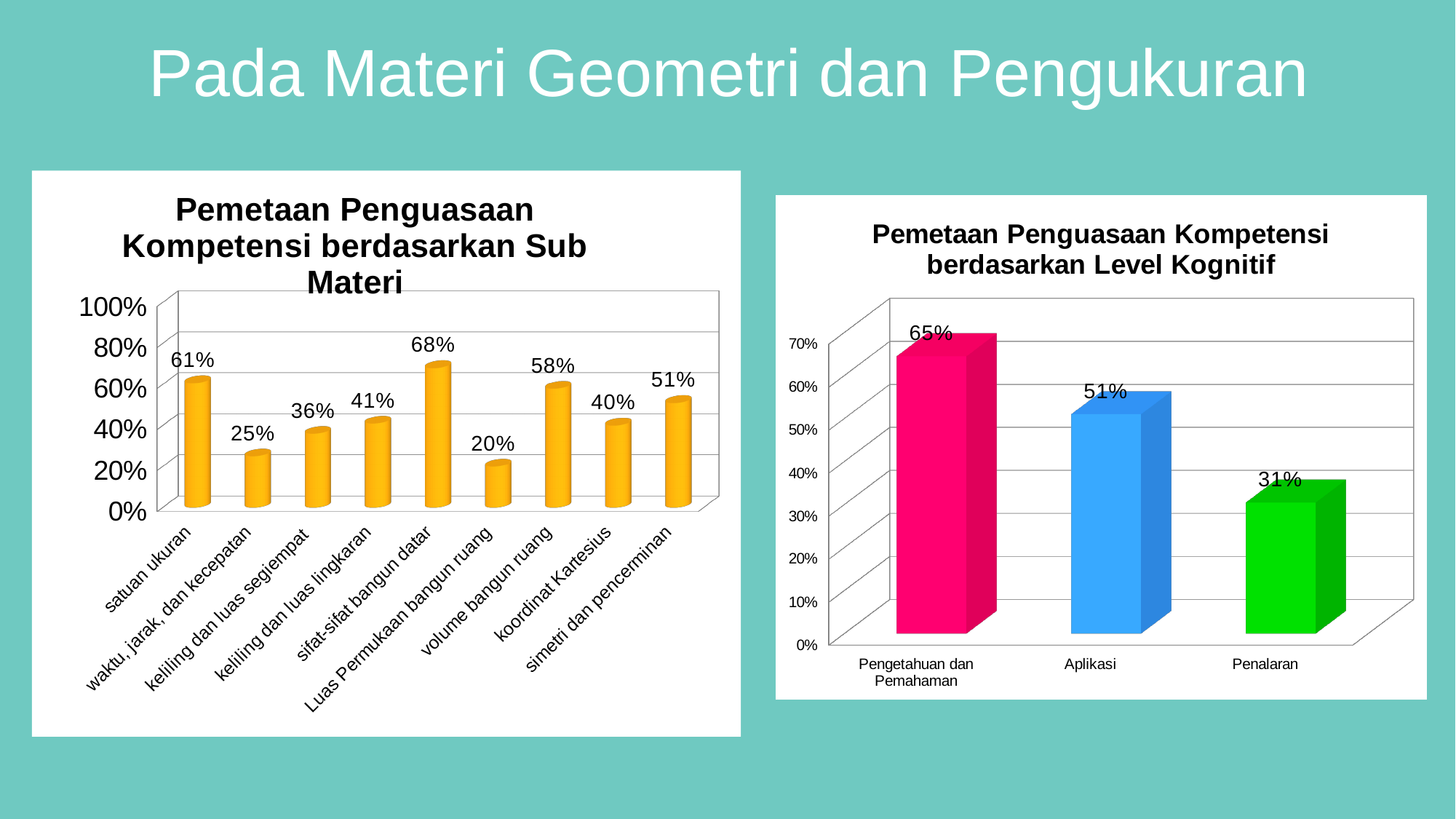
In the left chart (Pemetaan Penguasaan Kompetensi berdasarkan Sub Materi), how many sub materi categories are shown? 9 In the right chart (Pemetaan Penguasaan Kompetensi berdasarkan Level Kognitif), which level has the lowest value? Penalaran In the left chart (Pemetaan Penguasaan Kompetensi berdasarkan Sub Materi), what is the value for koordinat Kartesius? 40% In the right chart (Pemetaan Penguasaan Kompetensi berdasarkan Level Kognitif), what is the value for Aplikasi? 51% In the left chart (Pemetaan Penguasaan Kompetensi berdasarkan Sub Materi), which sub materi has the highest value? sifat-sifat bangun datar In the right chart (Pemetaan Penguasaan Kompetensi berdasarkan Level Kognitif), do the values rise or fall from left to right? fall In the left chart (Pemetaan Penguasaan Kompetensi berdasarkan Sub Materi), what is the value for sifat-sifat bangun datar? 68% In the left chart (Pemetaan Penguasaan Kompetensi berdasarkan Sub Materi), what is the difference between satuan ukuran and waktu, jarak, dan kecepatan? 36% In the left chart (Pemetaan Penguasaan Kompetensi berdasarkan Sub Materi), which sub materi has the lowest value? Luas Permukaan bangun ruang In the right chart (Pemetaan Penguasaan Kompetensi berdasarkan Level Kognitif), what is the difference between Pengetahuan dan Pemahaman and Penalaran? 34% What type of chart is the right chart (Pemetaan Penguasaan Kompetensi berdasarkan Level Kognitif)? bar chart In the left chart (Pemetaan Penguasaan Kompetensi berdasarkan Sub Materi), which is larger: volume bangun ruang or simetri dan pencerminan? volume bangun ruang